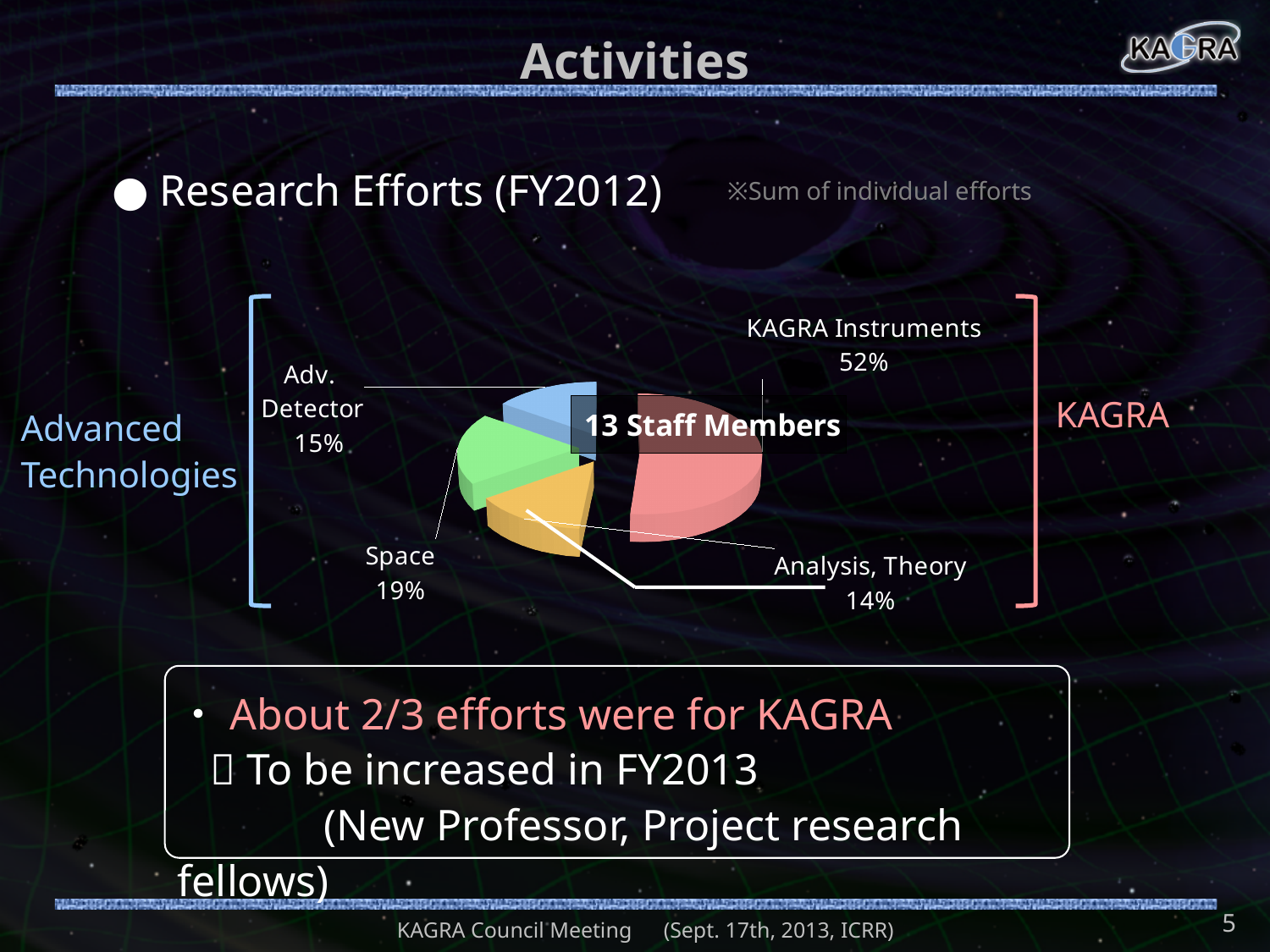
What percentage is shown for the Space slice? 19% What is the difference in percentage points between KAGRA Instruments and Space? 33 How many slices does the pie chart have? 4 What share of research efforts is labelled for KAGRA Instruments? 52% What percentage is shown for Adv. Detector? 15% What percentage is shown for Analysis, Theory? 14% What kind of chart is shown on the slide? Pie chart Which slice of the pie chart is the largest? KAGRA Instruments Which slice of the pie chart is the smallest? Analysis, Theory What is the combined share of the KAGRA Instruments and Analysis, Theory slices? 66% What text is printed in the box overlaid on the pie chart? 13 Staff Members Which is larger, the Space slice or the Adv. Detector slice? Space